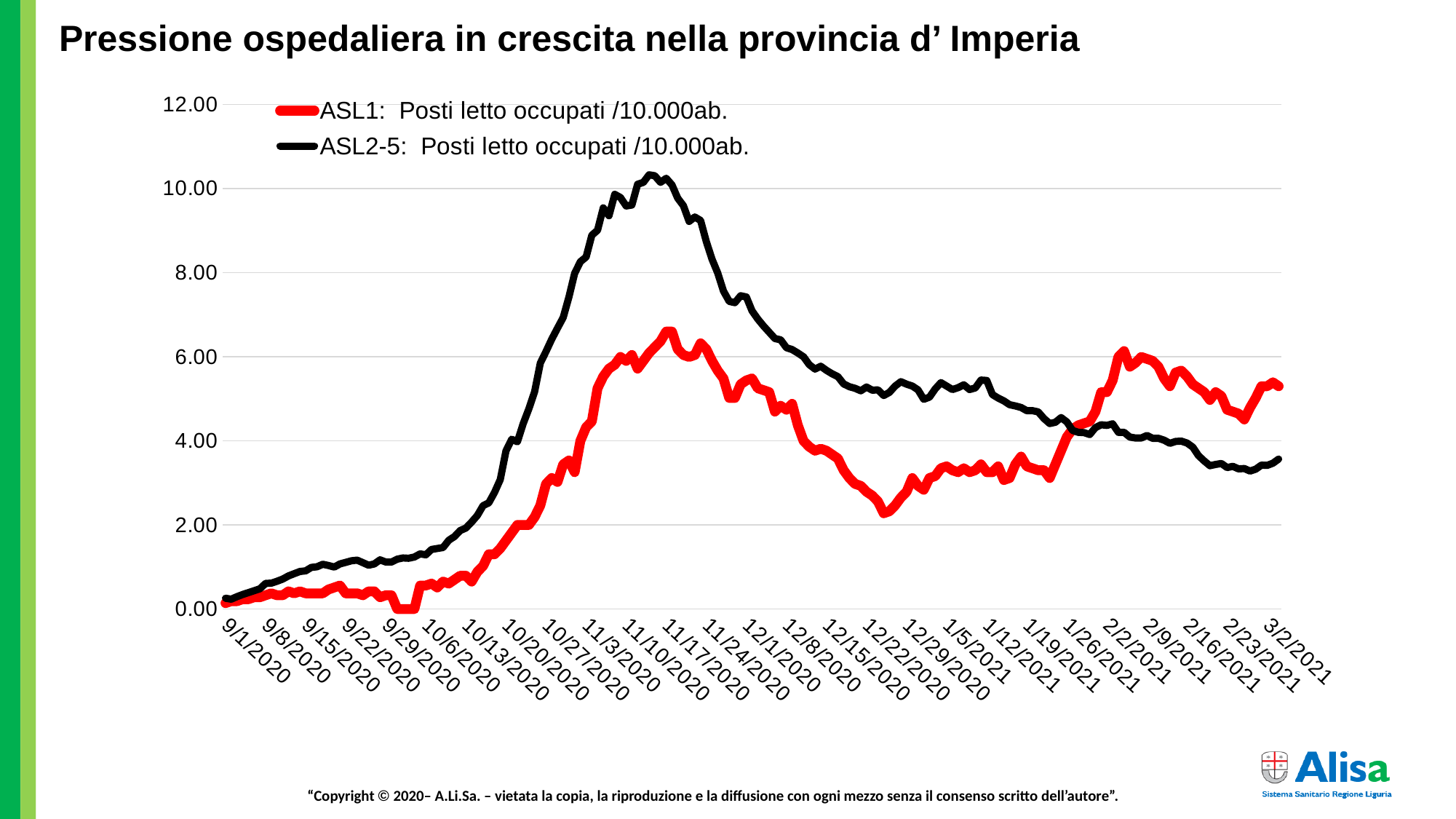
What is the title of the slide's chart? Pressione ospedaliera in crescita nella provincia d' Imperia Does the ASL2-5 series rise or fall between 11/10/2020 and 3/2/2021? fall Which colour is used for the ASL1 series? red At 3/2/2021, which series has the higher value, ASL1 or ASL2-5? ASL1 What kind of chart is shown on the slide? line chart How many series does the legend list? 2 At 3/2/2021, is the value for ASL2-5 greater or less than 4.00? less Around 11/10/2020, which series has the higher value, ASL1 or ASL2-5? ASL2-5 Around 12/22/2020, is the value for ASL1 greater or less than 4.00? less Around 11/10/2020, is the value for ASL2-5 greater or less than 8.00? greater Which series reaches the higher peak value over the whole period? ASL2-5: Posti letto occupati /10.000ab.